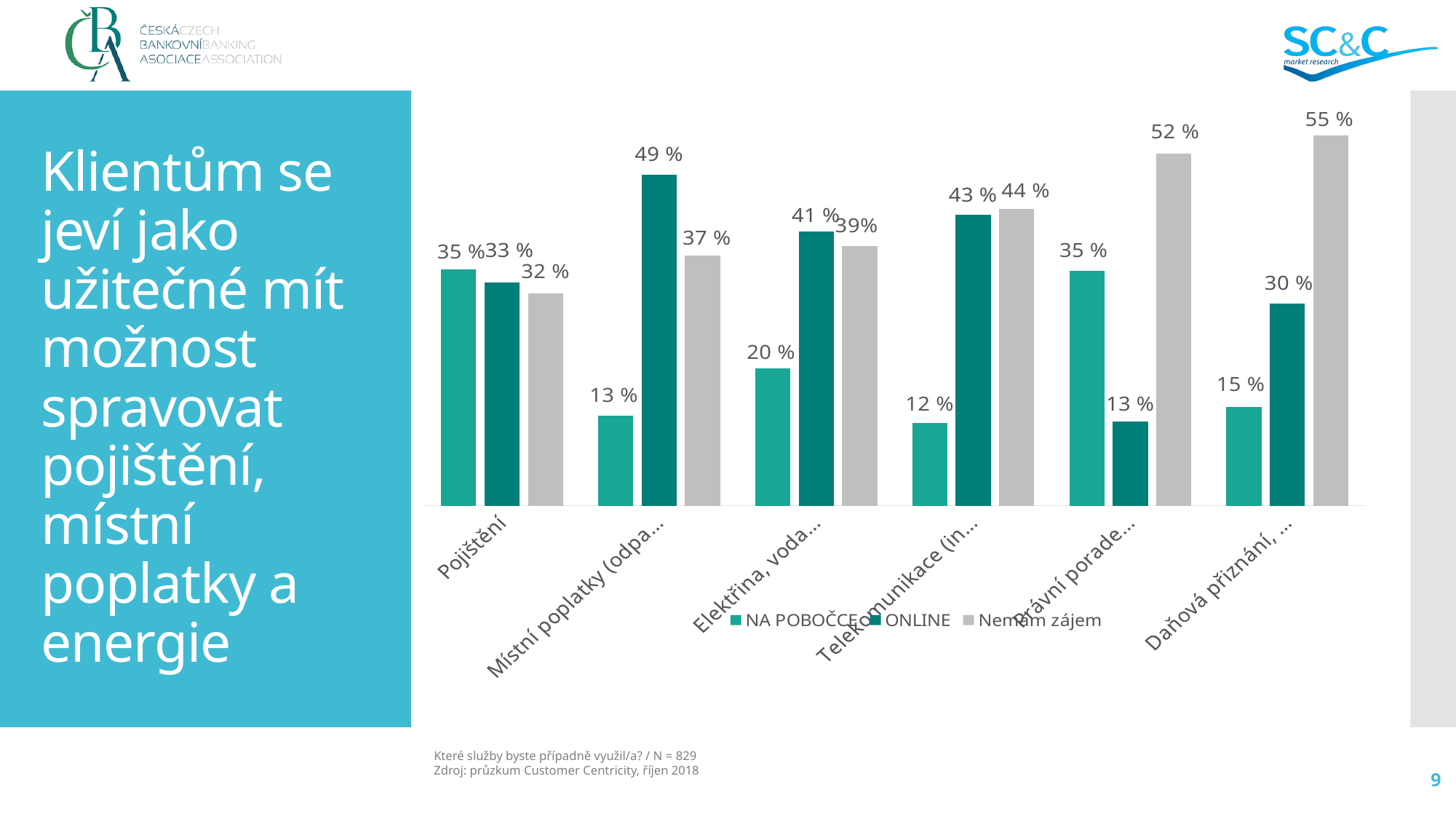
What is the value of NA POBOČCE for Pojištění? 35 % How many series does the legend list? 3 Which category has the lowest ONLINE value? Právní porade... How many categories are shown on the x axis? 6 Which category has the highest Nemám zájem value? Daňová přiznání, ... What kind of chart is shown on the slide? bar chart Which series is shown in grey in the legend? Nemám zájem For the category starting 'Elektřina, voda', which is larger: ONLINE or NA POBOČCE? ONLINE What is the value of Nemám zájem for the category starting 'Daňová přiznání'? 55 % What is the value of NA POBOČCE for the category starting 'Telekomunikace'? 12 % What is the difference between the Nemám zájem value and the NA POBOČCE value for the category starting 'Právní porade'? 17 % What is the value of ONLINE for the category starting 'Místní poplatky'? 49 %